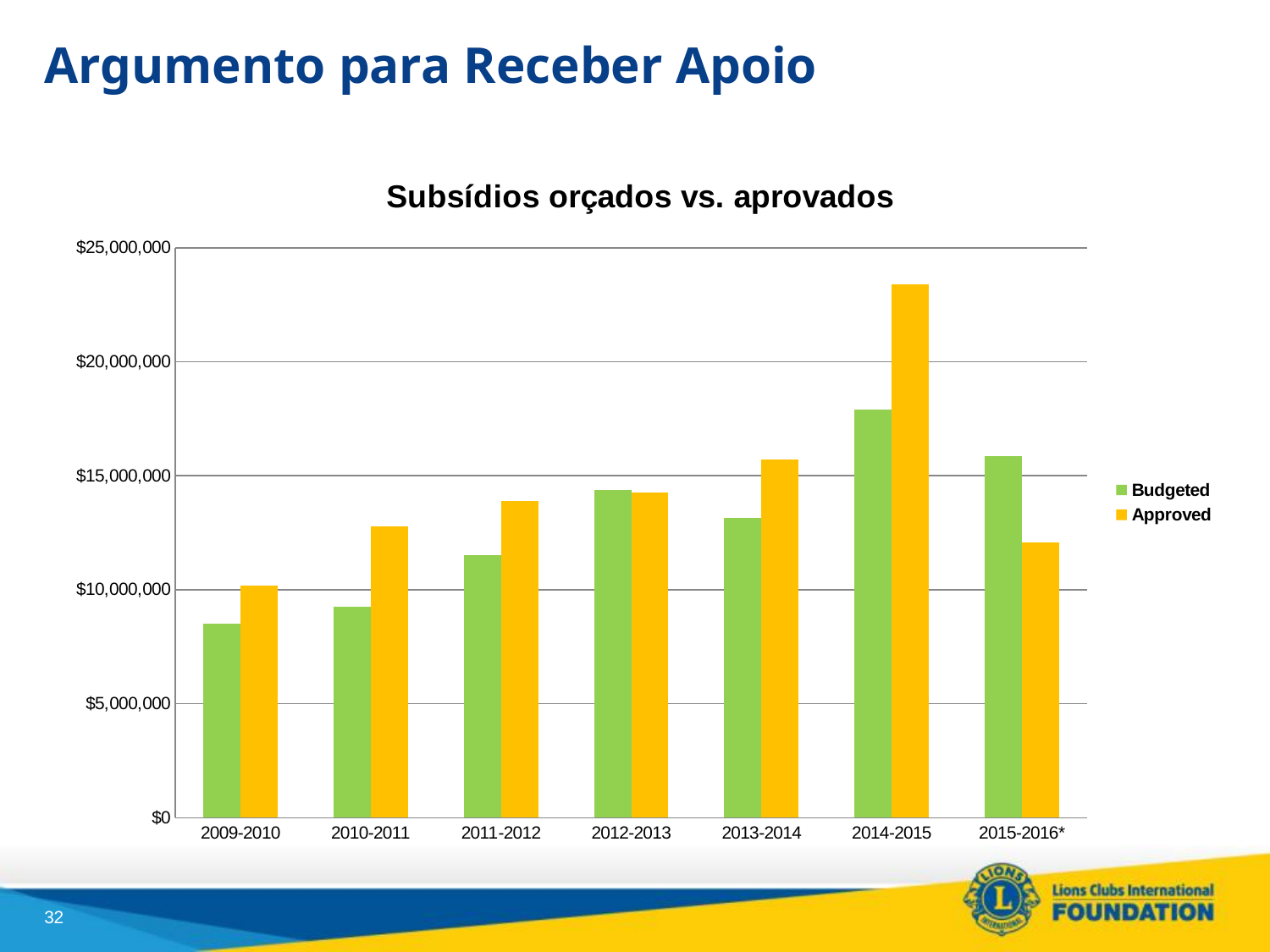
How many fiscal-year categories are shown on the x axis? 7 How many series does the legend list? 2 Is the Budgeted value for 2009-2010 greater or less than $10,000,000? less Is the Approved value for 2014-2015 greater or less than $20,000,000? greater Is the Budgeted value for 2014-2015 greater or less than $15,000,000? greater What kind of chart is shown on the slide? Bar chart What is the title of the chart? Subsídios orçados vs. aprovados Which fiscal year has the lowest Budgeted value? 2009-2010 For 2013-2014, which is larger, the Budgeted or the Approved value? Approved Which fiscal year has the highest Approved value? 2014-2015 Which fiscal year has the highest Budgeted value? 2014-2015 For 2015-2016*, which is larger, the Budgeted or the Approved value? Budgeted